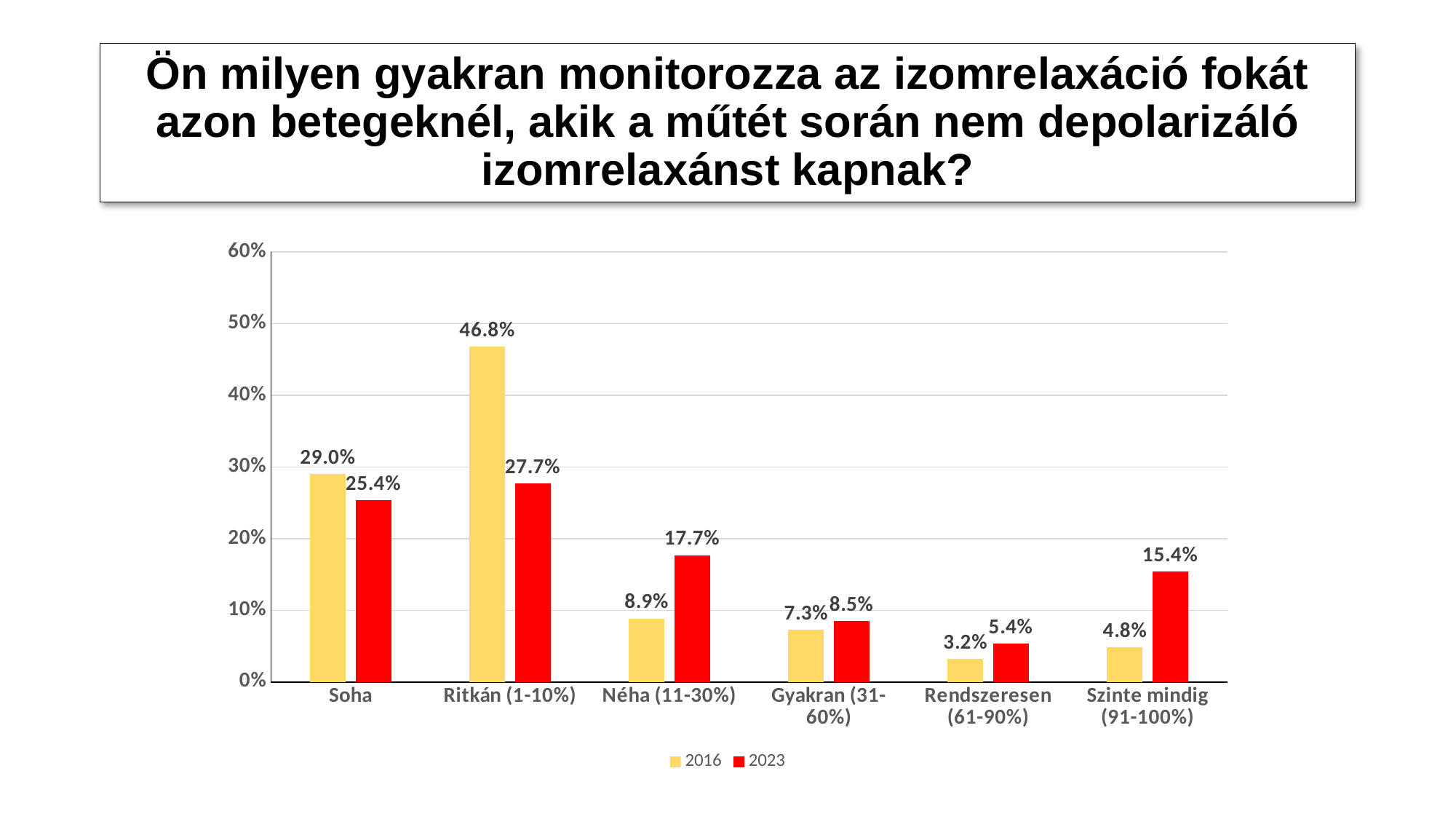
What is the 2016 value for Ritkán (1-10%)? 46.8% How many series does the legend list? 2 Which category has the highest 2016 value? Ritkán (1-10%) What is the 2023 value for Szinte mindig (91-100%)? 15.4% How many categories are shown on the x axis? 6 Which is larger for Szinte mindig (91-100%): the 2016 value or the 2023 value? 2023 Which colour represents the 2023 series? Red What kind of chart is shown on the slide? Bar chart What is the 2023 value for Néha (11-30%)? 17.7% Which category has the lowest 2023 value? Rendszeresen (61-90%) What is the difference between the 2016 and 2023 values for Ritkán (1-10%)? 19.1% Is the 2016 value for Soha greater or less than 20%? greater